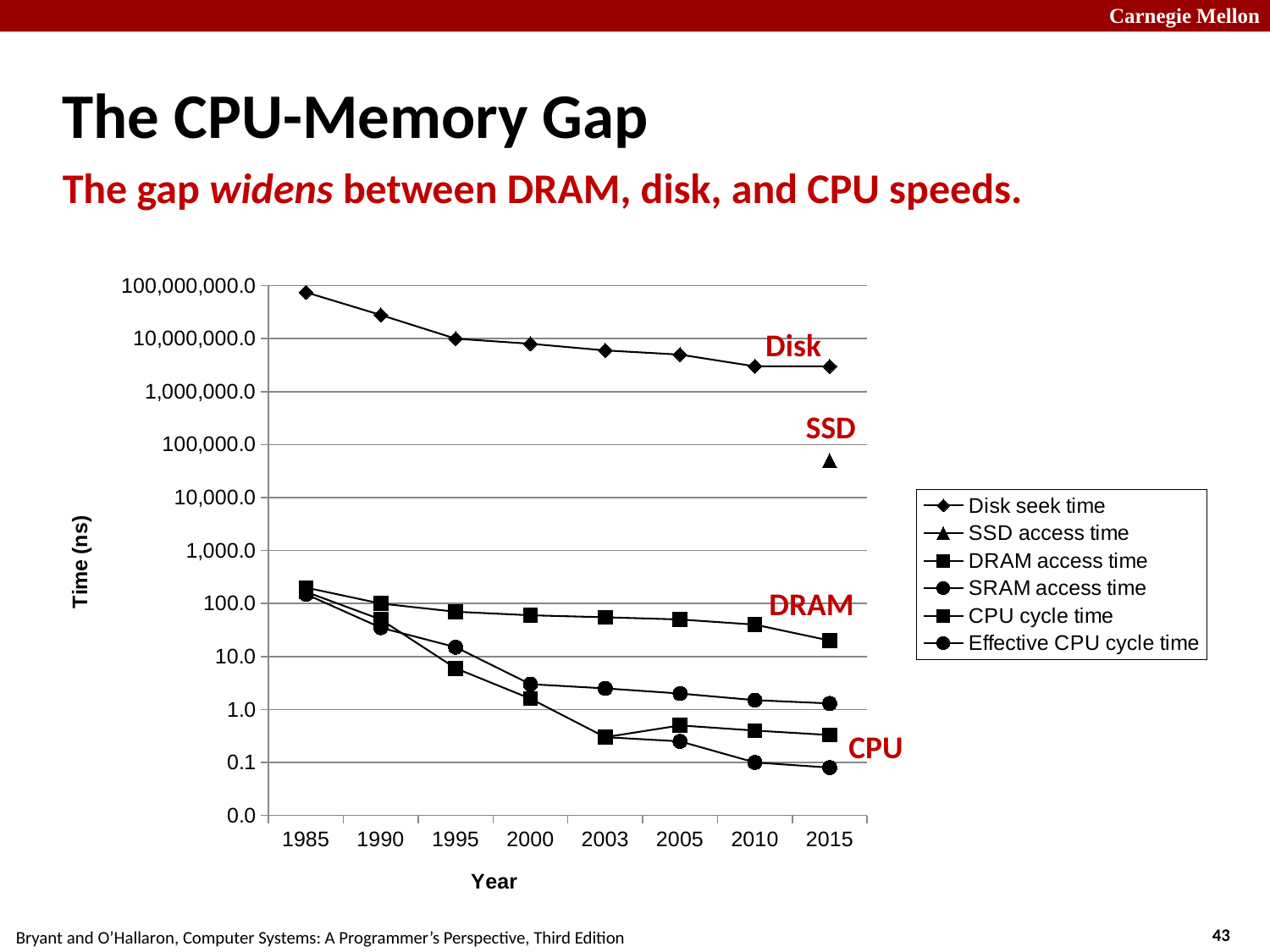
Is the SSD access time in 2015 greater or less than 100,000.0? less Is the Disk seek time in 1985 greater or less than 10,000,000.0? greater How many series does the legend list? 6 Does the Disk seek time rise or fall from 1985 to 2015? fall Does the DRAM access time rise or fall from 1985 to 2015? fall What is the label of the y axis? Time (ns) Which series has the lowest value in 2015? Effective CPU cycle time How many years are marked along the x axis? 8 What kind of chart is shown on the slide? line chart Is the Disk seek time in 2015 greater or less than 1,000,000.0? greater Which series has the highest values across all years? Disk seek time